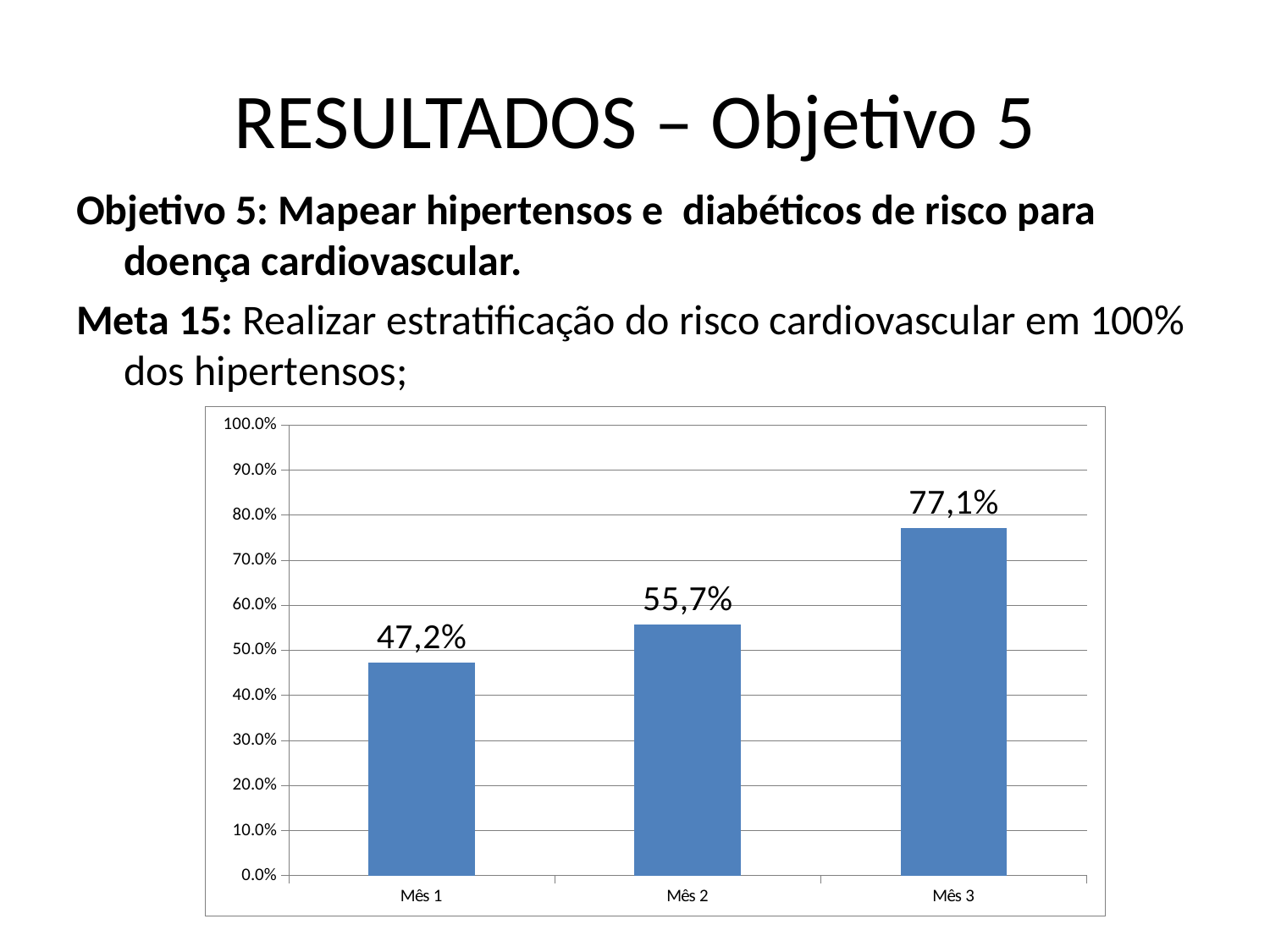
What is the value for Mês 3? 77,1% What is the value for Mês 1? 47,2% What is the value for Mês 2? 55,7% What is the difference between the values for Mês 2 and Mês 1? 8,5% How many categories are shown on the x axis? 3 What is the difference between the values for Mês 3 and Mês 1? 29,9% What kind of chart is shown on the slide? Bar chart Do the values rise or fall from Mês 1 to Mês 3? Rise Is the value for Mês 2 greater or less than 50.0%? greater Which month has the highest value? Mês 3 Which month has the lowest value? Mês 1 Which is larger, the value for Mês 2 or the value for Mês 3? Mês 3